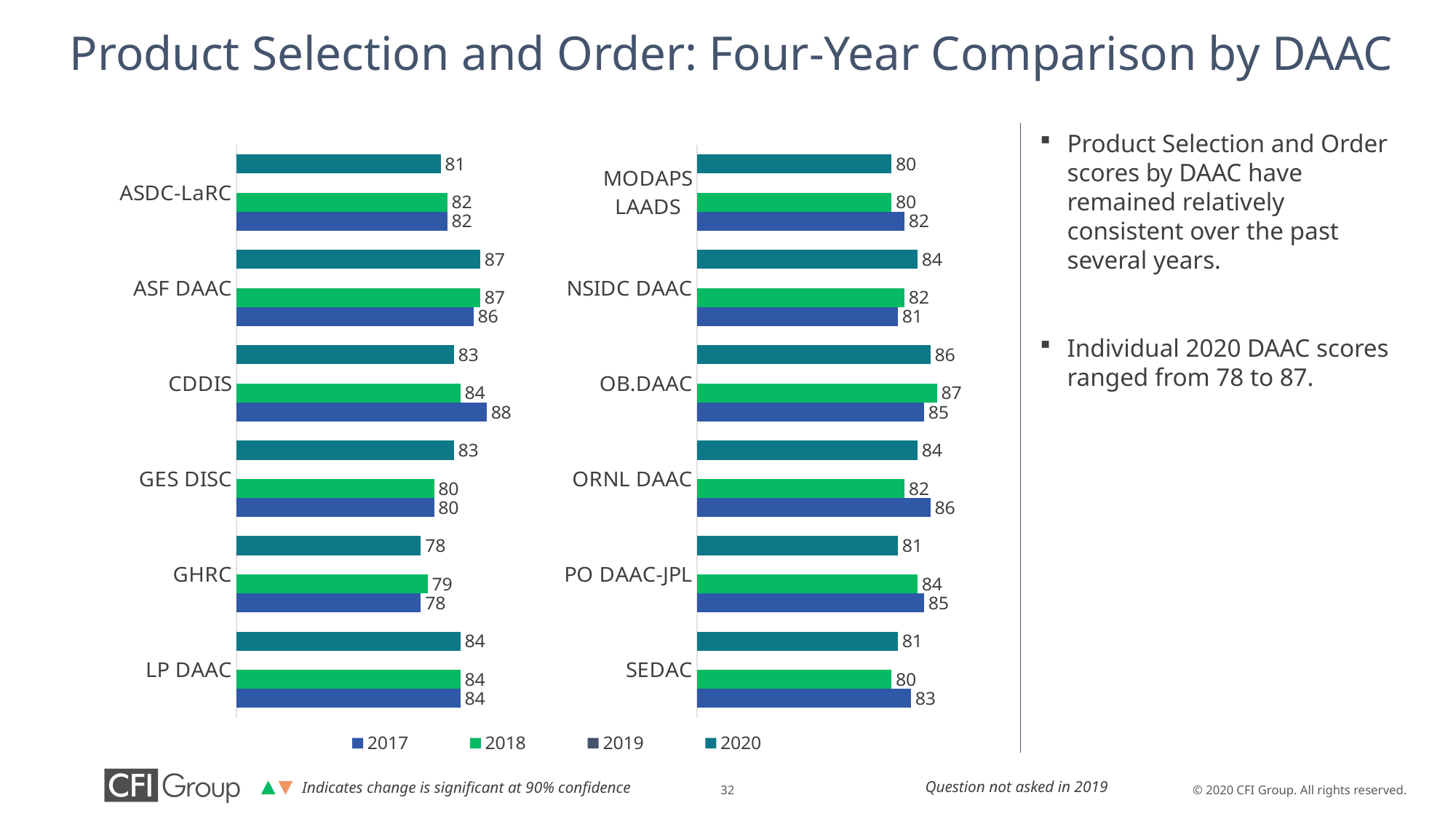
On the left chart, what is the difference between the 2017 and 2020 values for CDDIS? 5 How many DAACs are shown on the left chart? 6 On the right chart, which is larger for PO DAAC-JPL: the 2017 value or the 2020 value? 2017 On the left chart, which DAAC has the lowest 2020 value? GHRC On the right chart, what is the 2018 value for OB.DAAC? 87 What kind of chart is used on this slide? Bar chart On the left chart, what is the 2017 value for CDDIS? 88 How many series does the legend list? 4 On the right chart, which DAAC has the highest 2020 value? OB.DAAC On the right chart, what is the difference between the 2017 and 2020 values for NSIDC DAAC? 3 On the left chart, what is the 2020 value for ASF DAAC? 87 On the right chart, what is the 2020 value for SEDAC? 81